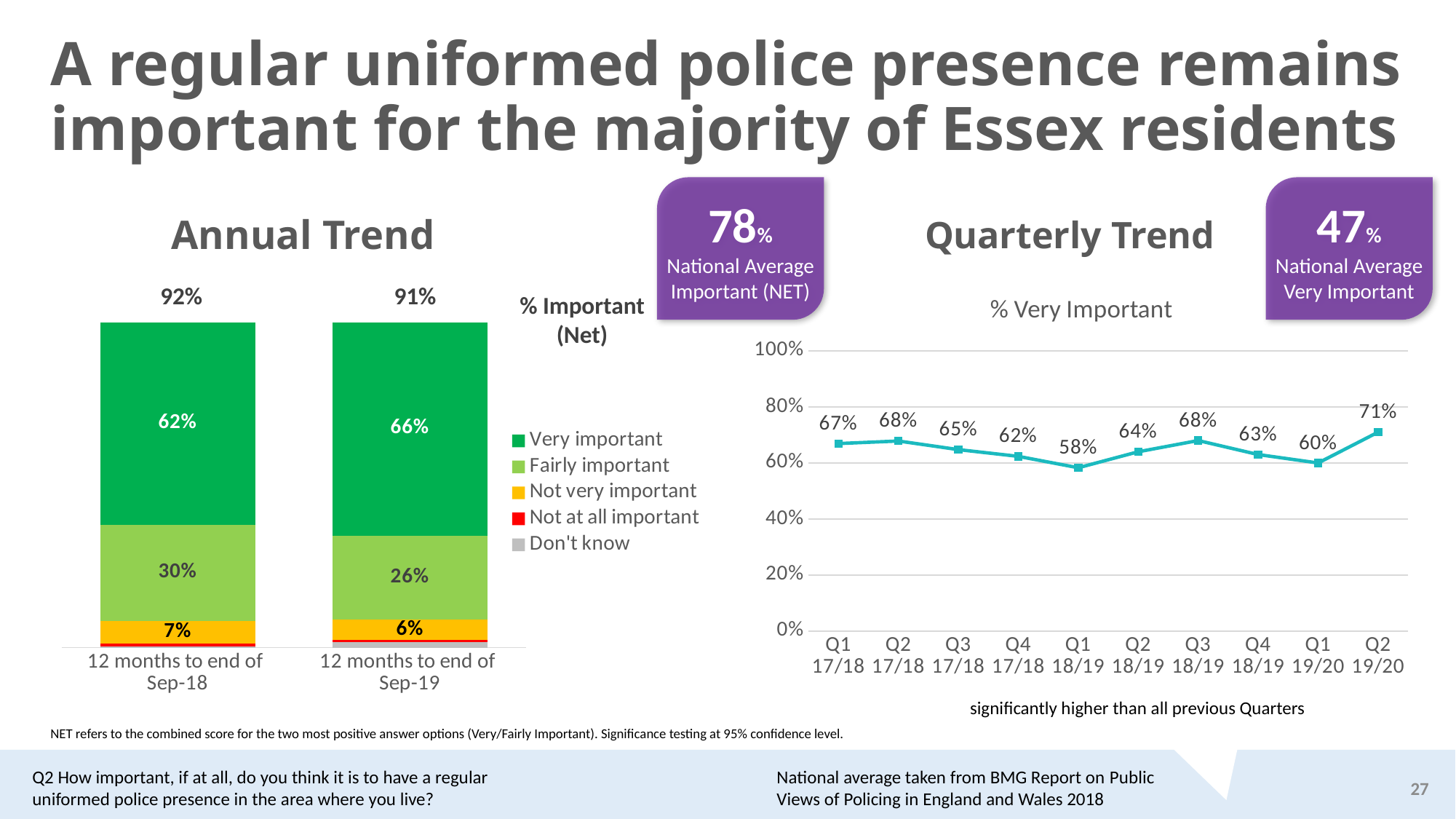
In the Annual Trend chart, what is the difference between the 'Very important' values for Sep-19 and Sep-18? 4 percentage points In the Quarterly Trend chart, what is the % Very Important value for Q1 18/19? 58% In the Quarterly Trend chart, which quarter has the lowest % Very Important value? Q1 18/19 In the Annual Trend chart, what percentage said 'Very important' in the 12 months to end of Sep-19? 66% In the Annual Trend chart, what is the 'Fairly important' value for the 12 months to end of Sep-18? 30% In the Quarterly Trend chart, which quarter has the highest % Very Important value? Q2 19/20 What kind of chart is the Annual Trend chart? Stacked bar chart In the Quarterly Trend chart, how many quarters are plotted? 10 In the Annual Trend chart, which period has the larger 'Not very important' value, Sep-18 or Sep-19? 12 months to end of Sep-18 In the Annual Trend chart, what is the % Important (Net) figure shown above the bar for the 12 months to end of Sep-19? 91% In the Quarterly Trend chart, what is the difference between the values for Q2 19/20 and Q1 19/20? 11 percentage points In the Annual Trend chart, how many series does the legend list? 5